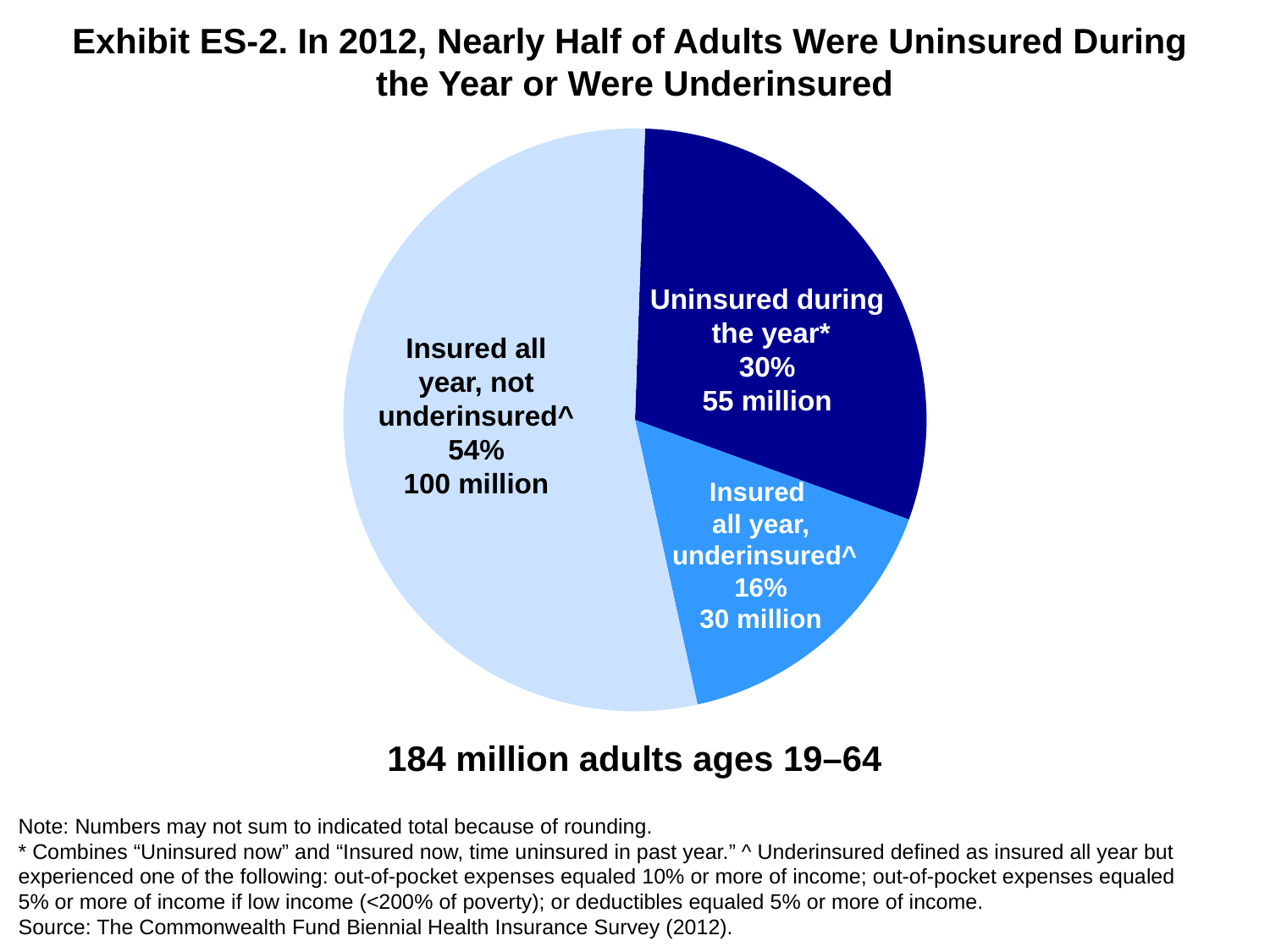
How many adults were uninsured during the year? 55 million What total number of adults does the chart represent? 184 million adults ages 19–64 What percentage of adults were insured all year, underinsured? 16% How many adults were insured all year, not underinsured? 100 million What is the source of the data shown in the chart? The Commonwealth Fund Biennial Health Insurance Survey (2012) What kind of chart is shown on the slide? pie chart What is the difference in percentage points between the 'Uninsured during the year' slice and the 'Insured all year, underinsured' slice? 14 percentage points How many slices does the pie chart have? 3 What percentage of adults were insured all year, not underinsured? 54% Which is larger: the number of adults uninsured during the year or the number insured all year, underinsured? Uninsured during the year Which slice of the pie is the smallest? Insured all year, underinsured Which slice of the pie is the largest? Insured all year, not underinsured